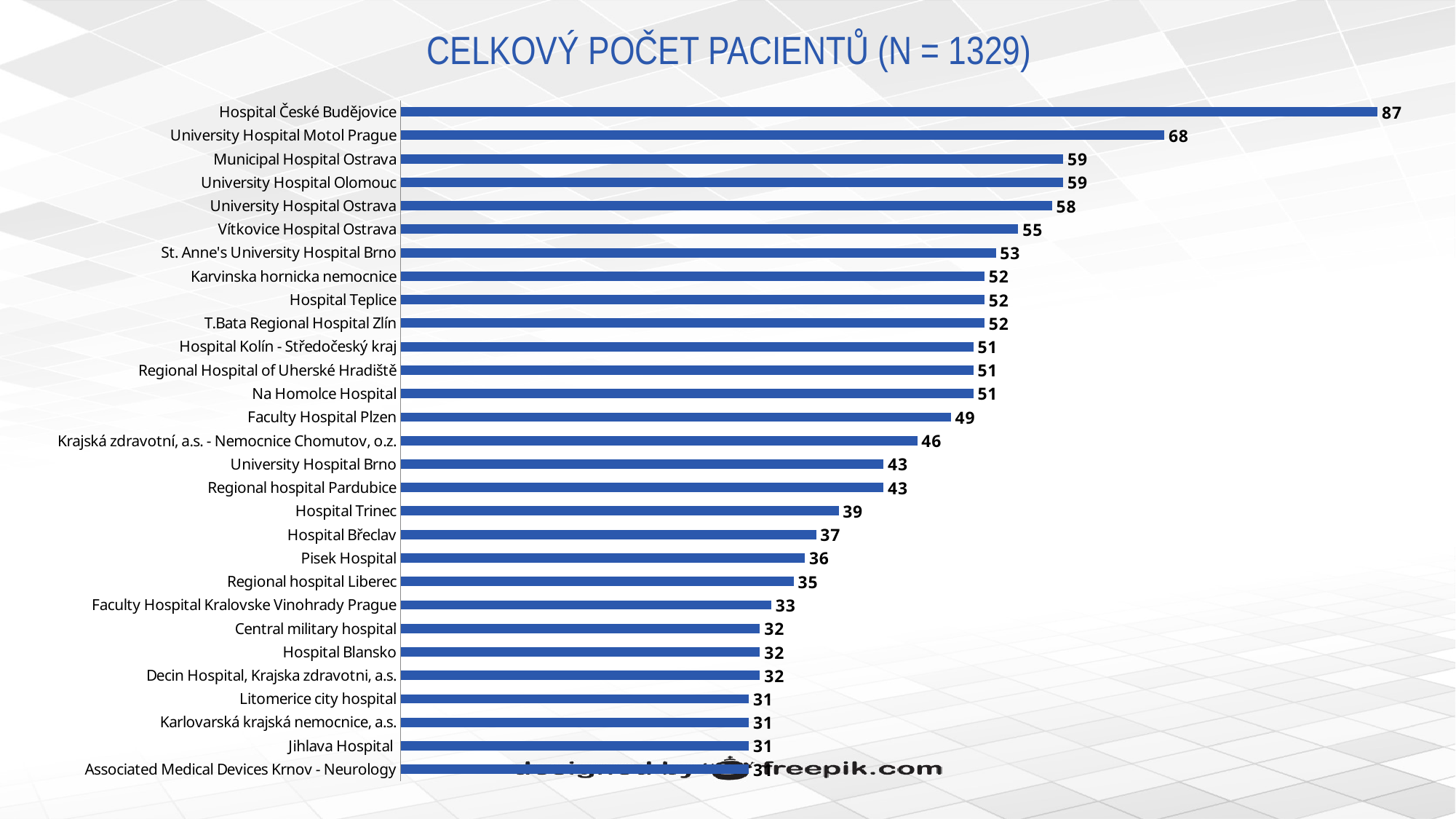
Which is larger, the value for University Hospital Brno or the value for St. Anne's University Hospital Brno? St. Anne's University Hospital Brno Which hospital has the highest number of patients? Hospital České Budějovice How many hospitals are listed on the chart? 29 What is the value for Hospital České Budějovice? 87 What is the difference between the values for Vítkovice Hospital Ostrava and Hospital Břeclav? 18 What kind of chart is shown on the slide? bar chart What is the value for University Hospital Motol Prague? 68 What is the title of the chart? CELKOVÝ POČET PACIENTŮ (N = 1329) What is the value for Hospital Trinec? 39 What is the value for Faculty Hospital Plzen? 49 What is the value for Regional hospital Liberec? 35 What is the difference between the values for Hospital České Budějovice and University Hospital Motol Prague? 19